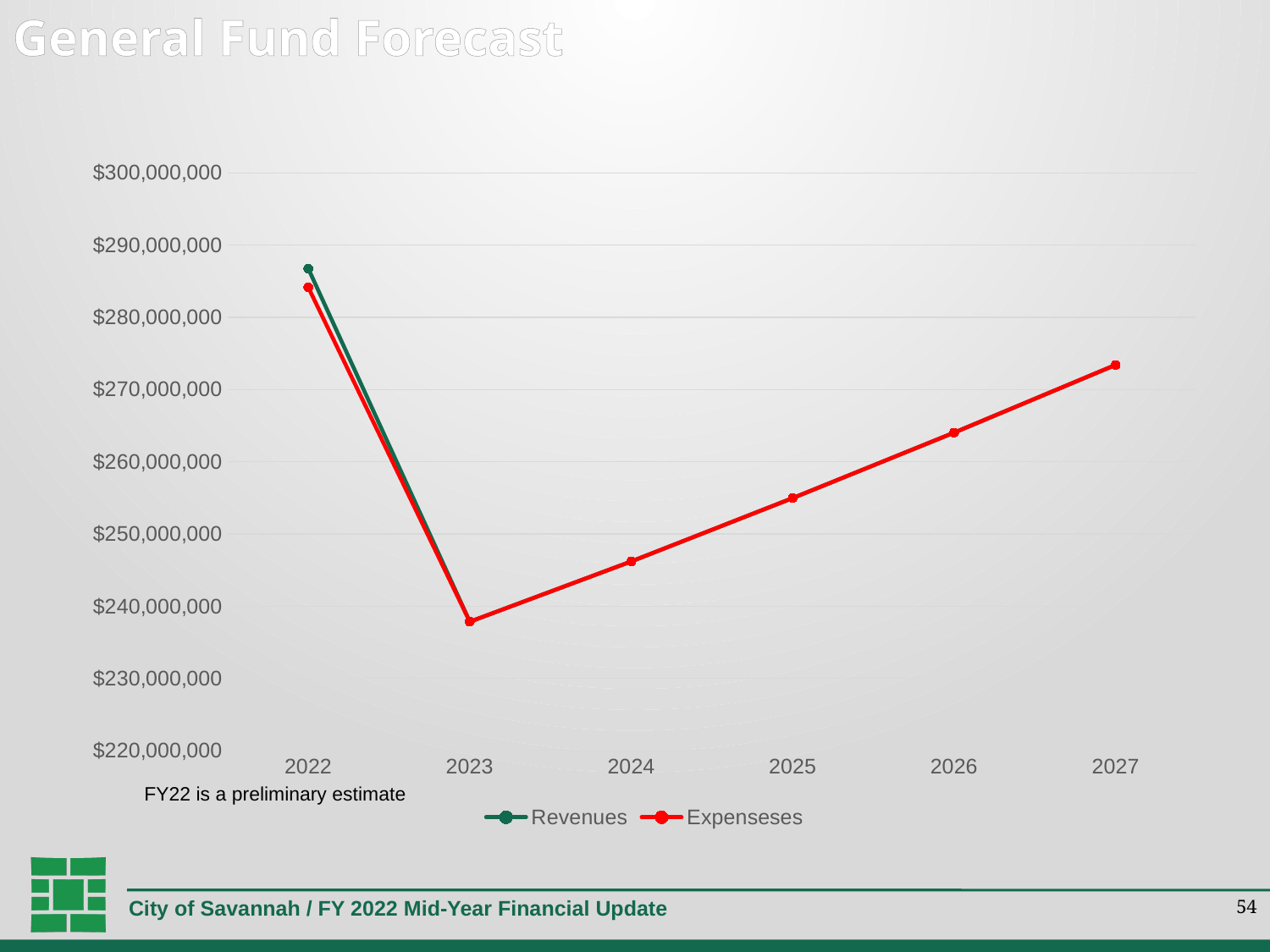
In which year do Expenseses reach their lowest value? 2023 How many years are plotted along the x axis? 6 Is the value for Expenseses in 2027 greater or less than $270,000,000? greater How many series does the legend list? 2 Which series is drawn in red? Expenseses Is the value for Revenues in 2022 greater or less than $280,000,000? greater In 2022, which is larger, Revenues or Expenseses? Revenues Is the value for Expenseses in 2023 greater or less than $240,000,000? less In which year are Expenseses highest? 2022 Do Expenseses rise or fall from 2023 to 2027? rise What is the title of the chart? General Fund Forecast What kind of chart is shown on the slide? line chart